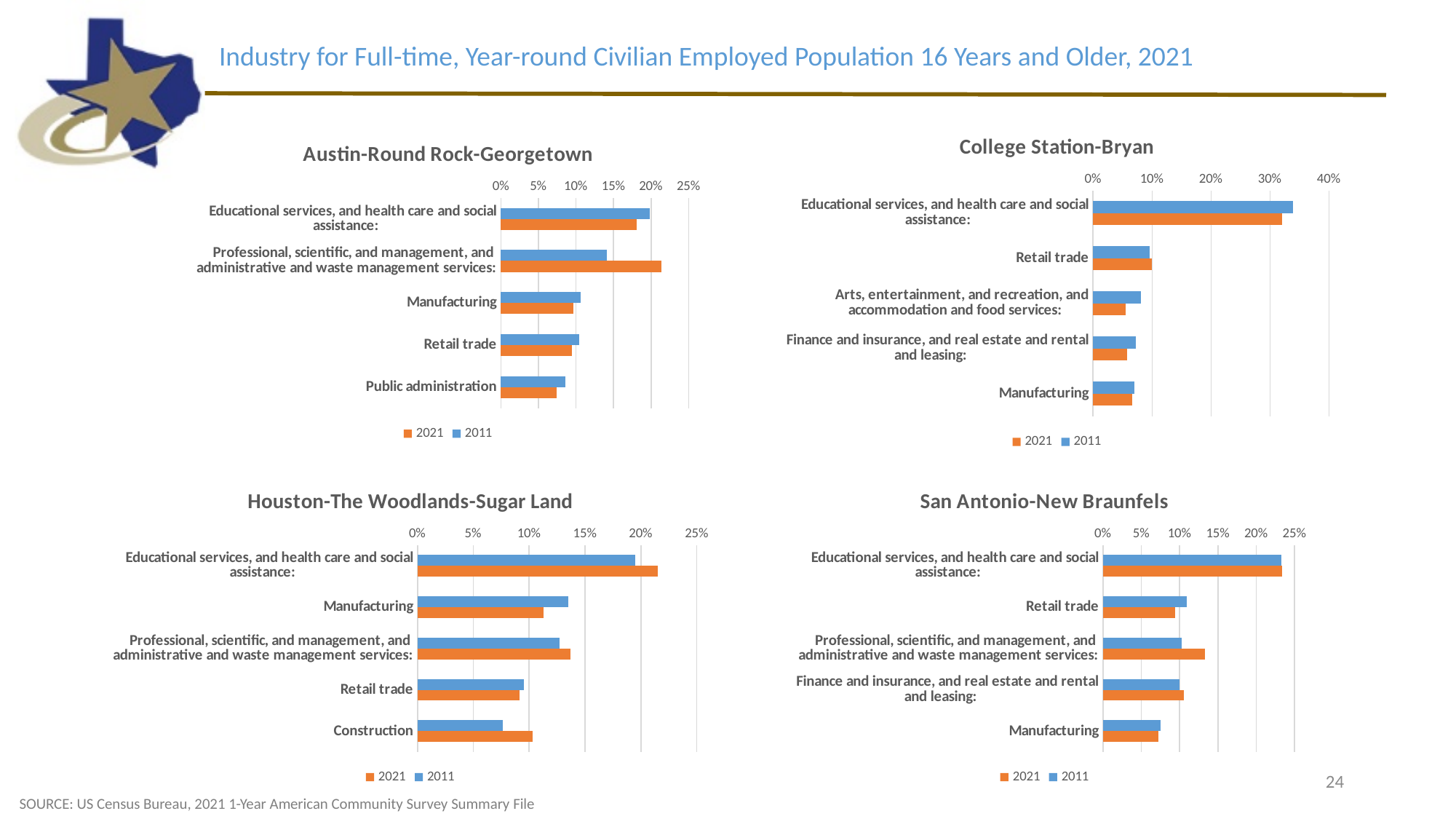
What kind of chart is the Austin-Round Rock-Georgetown chart? Bar chart In the San Antonio-New Braunfels chart, is the 2011 value for Educational services, and health care and social assistance greater or less than 20%? greater In the Austin-Round Rock-Georgetown chart, for Professional, scientific, and management, and administrative and waste management services, which year has the larger value, 2021 or 2011? 2021 How many industry categories are shown in the Houston-The Woodlands-Sugar Land chart? 5 In the Houston-The Woodlands-Sugar Land chart, which category has the highest 2021 value? Educational services, and health care and social assistance In the San Antonio-New Braunfels chart, which category has the lowest 2021 value? Manufacturing What are the two legend entries in the Houston-The Woodlands-Sugar Land chart? 2021 and 2011 How many series does the legend of the College Station-Bryan chart list? 2 In the College Station-Bryan chart, is the 2021 value for Educational services, and health care and social assistance greater or less than 30%? greater In the College Station-Bryan chart, is the 2021 value for Arts, entertainment, and recreation, and accommodation and food services greater or less than 10%? less In the Houston-The Woodlands-Sugar Land chart, for Construction, which year has the larger value, 2021 or 2011? 2021